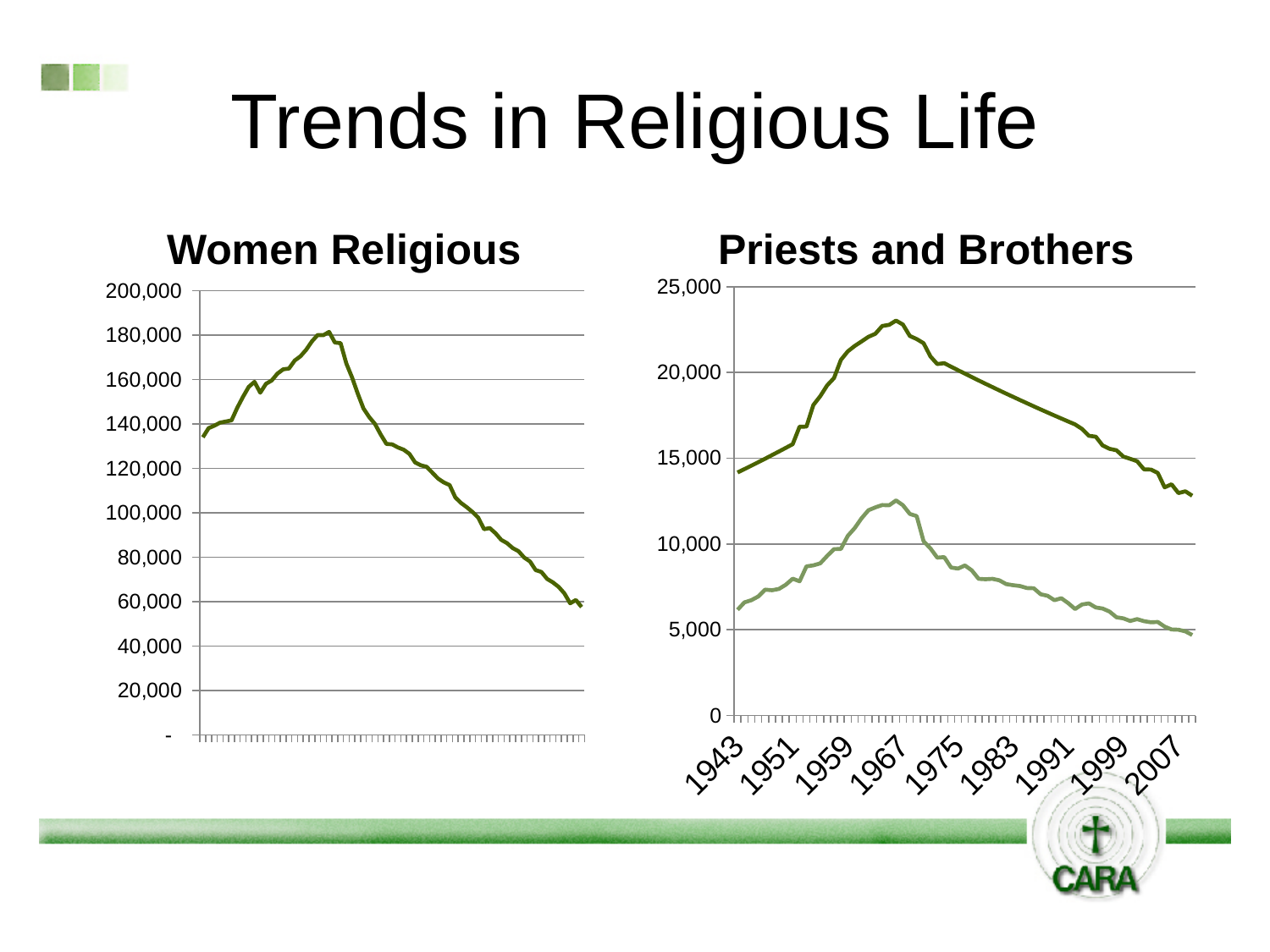
What kind of chart is the Women Religious chart? line chart On the Priests and Brothers chart, which line has the larger value in 1967, the upper line or the lower line? the upper line On the Priests and Brothers chart, is the upper line's value in 1943 greater or less than 15,000? less How many lines are plotted on the Priests and Brothers chart? 2 On the Priests and Brothers chart, is the lower line's peak value greater or less than 10,000? greater What is the highest value shown on the y axis of the Women Religious chart? 200,000 What is the first year label on the x axis of the Priests and Brothers chart? 1943 On the Women Religious chart, is the peak value greater or less than 160,000? greater On the Priests and Brothers chart, does the upper line rise or fall between 1975 and 2007? fall